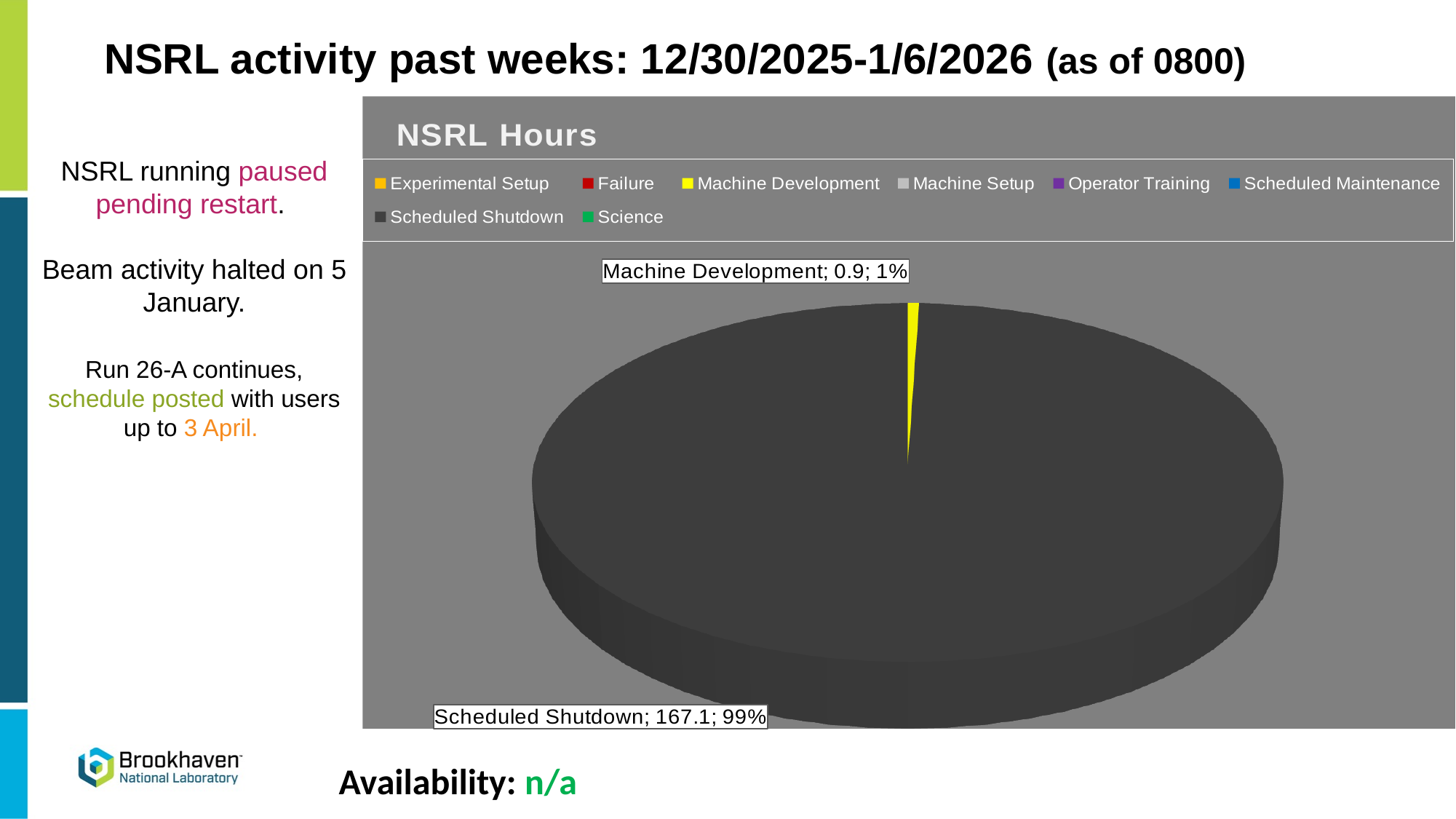
What colour is the Machine Development slice in the pie chart? yellow How many hours are shown for Scheduled Shutdown? 167.1 Which category has the largest slice of the pie? Scheduled Shutdown What kind of chart is shown on the slide? pie chart Which of the two labelled slices is smaller, Machine Development or Scheduled Shutdown? Machine Development What is the title of the chart? NSRL Hours Which is larger, the hours for Scheduled Shutdown or the hours for Machine Development? Scheduled Shutdown What share of the pie does Scheduled Shutdown take? 99% What share of the pie does Machine Development take? 1% How many hours are shown for Machine Development? 0.9 What is the difference in hours between Scheduled Shutdown and Machine Development? 166.2 How many series does the chart's legend list? 8